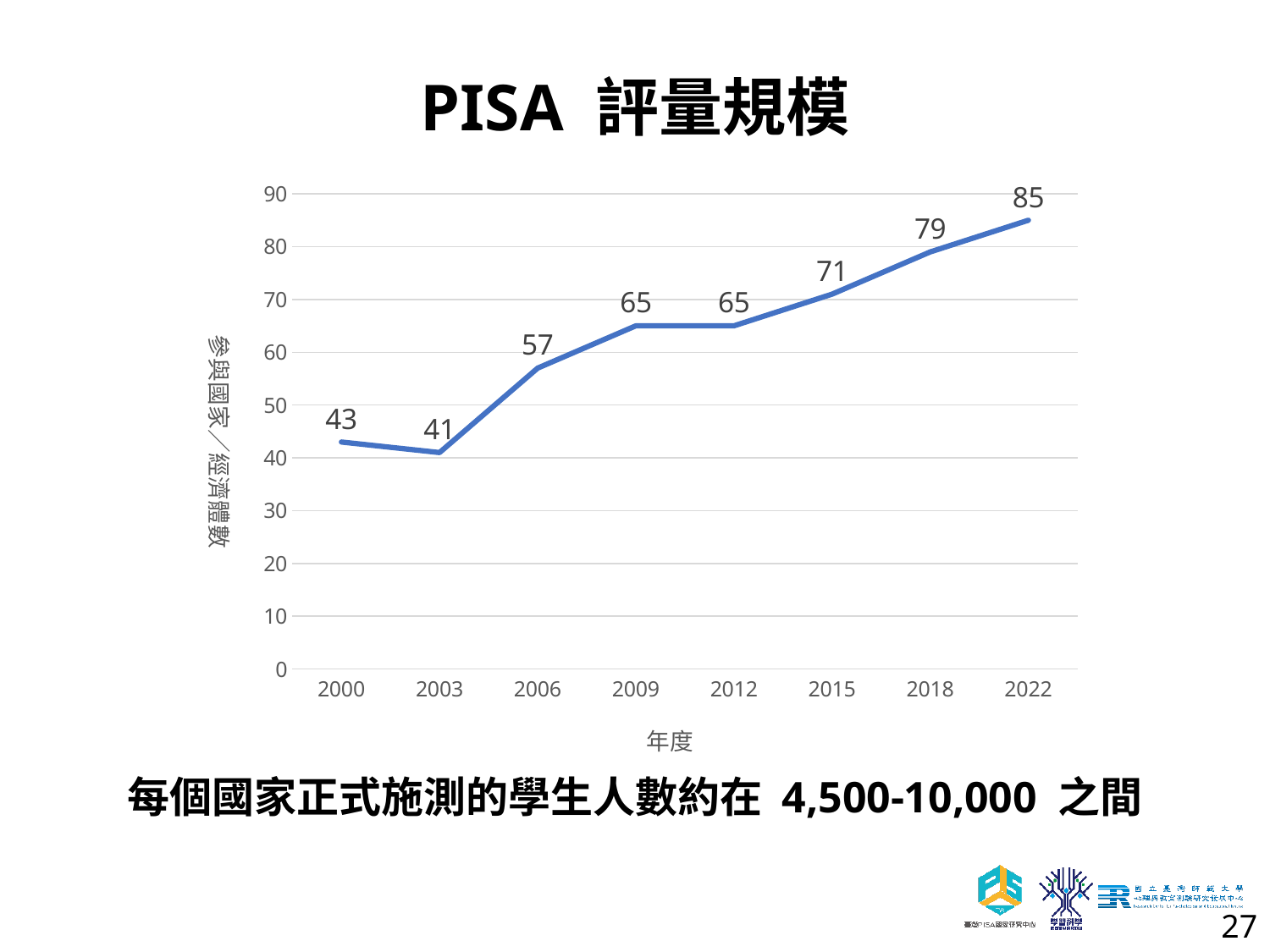
What is the value for 2000? 43 Do the values generally rise or fall from 2003 to 2022? rise What is the difference between the values for 2022 and 2000? 42 Is the value for 2009 greater or less than 60? greater What kind of chart is shown? line chart How many years are plotted on the x axis? 8 Which year has the lowest value? 2003 What is the title of the chart? PISA 評量規模 Which is larger, the value for 2003 or the value for 2015? 2015 What is the value for 2006? 57 What is the value for 2018? 79 Which year has the highest value? 2022